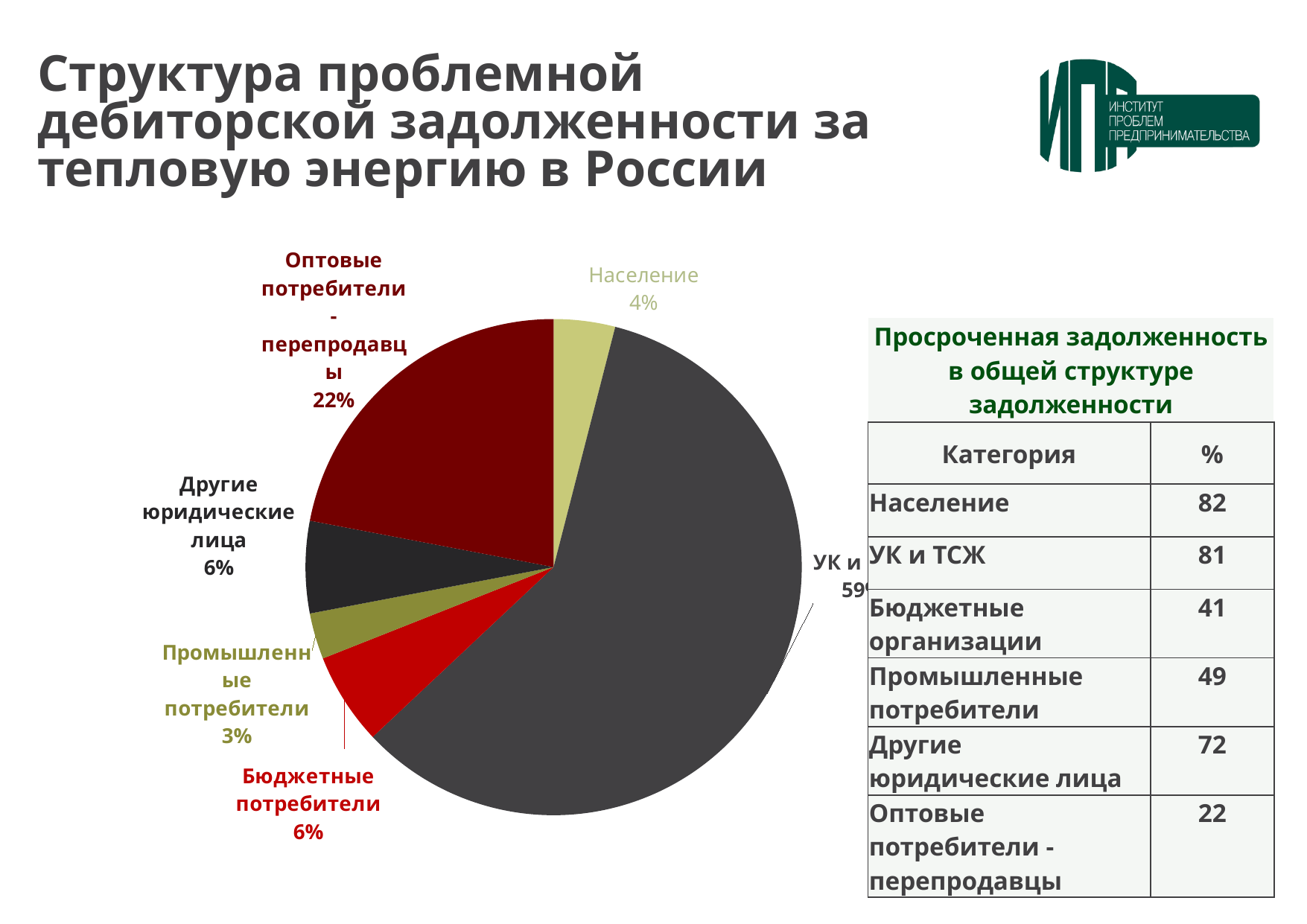
What share of the pie does Промышленные потребители have? 3% Which is larger in the pie chart: Оптовые потребители - перепродавцы or Население? Оптовые потребители - перепродавцы What share of the pie does Оптовые потребители - перепродавцы have? 22% How many slices does the pie chart have? 6 What share of the pie does Другие юридические лица have? 6% What kind of chart is shown on the slide? Pie chart What share of the pie does Население have? 4% Which category has the largest slice of the pie? УК и ТСЖ Which category has the smallest slice of the pie? Промышленные потребители By how many percentage points does the share of Оптовые потребители - перепродавцы exceed that of Другие юридические лица? 16 percentage points What is the title of the slide containing the pie chart? Структура проблемной дебиторской задолженности за тепловую энергию в России What share of the pie does Бюджетные потребители have? 6%